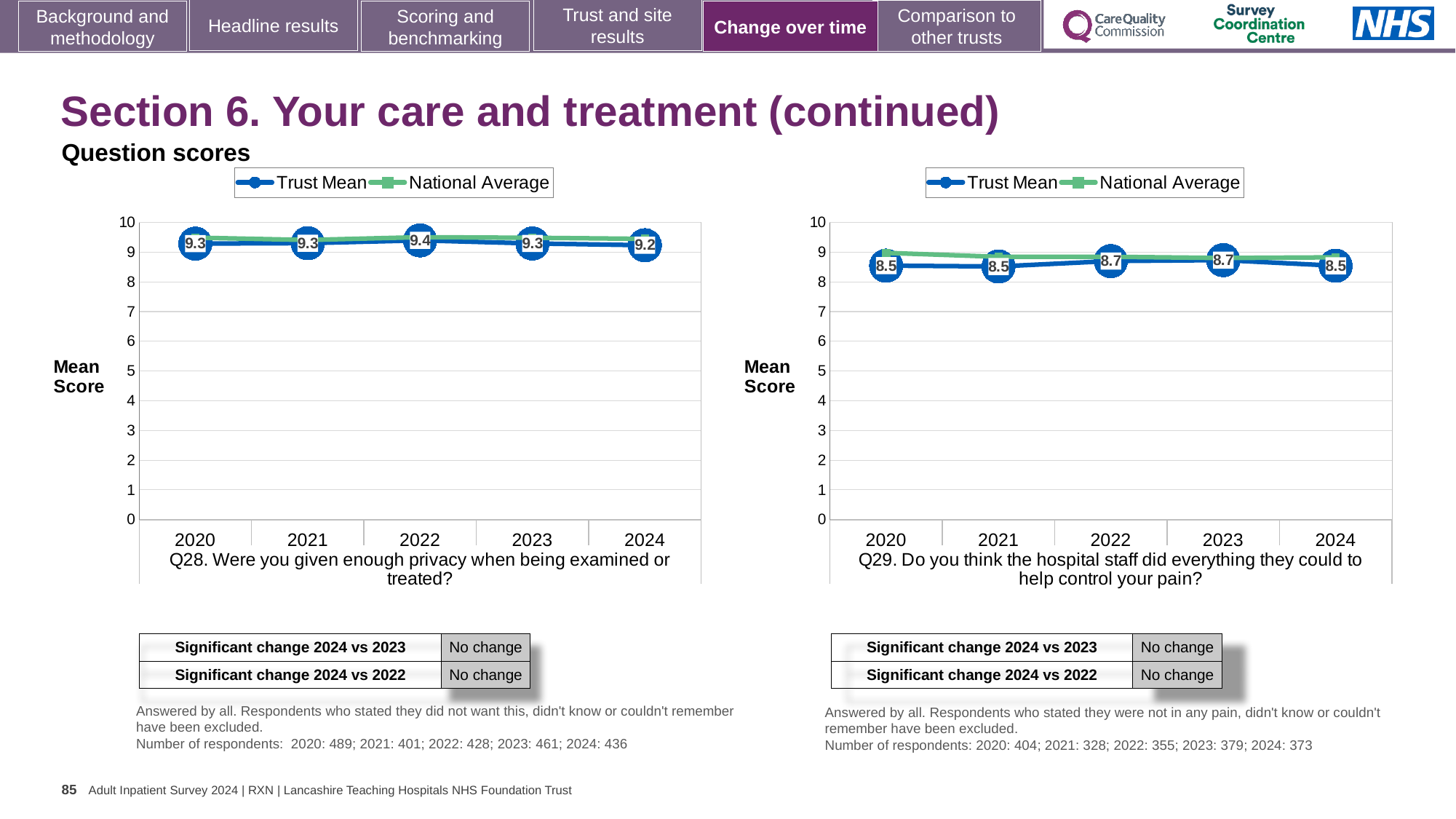
In the Q29 chart on the right, is the Trust Mean score for 2022 larger or smaller than the score for 2021? larger In the Q29 chart on the right, is the National Average value for 2020 greater or less than 8? greater What kind of chart is used for Q28 on the left? Line chart In the Q28 chart on the left, which year has the highest Trust Mean score? 2022 In the Q28 chart on the left, what is the difference between the Trust Mean scores for 2022 and 2024? 0.2 In the Q28 chart on the left, what is the Trust Mean score for 2022? 9.4 How many years are plotted on the x axis of the Q29 chart on the right? 5 In the Q28 chart on the left, what is the Trust Mean score for 2024? 9.2 In the Q29 chart on the right, what is the Trust Mean score for 2020? 8.5 In the Q28 chart on the left, which year has the lowest Trust Mean score? 2024 How many series does the legend of the Q28 chart on the left list? 2 In the Q29 chart on the right, what is the Trust Mean score for 2023? 8.7